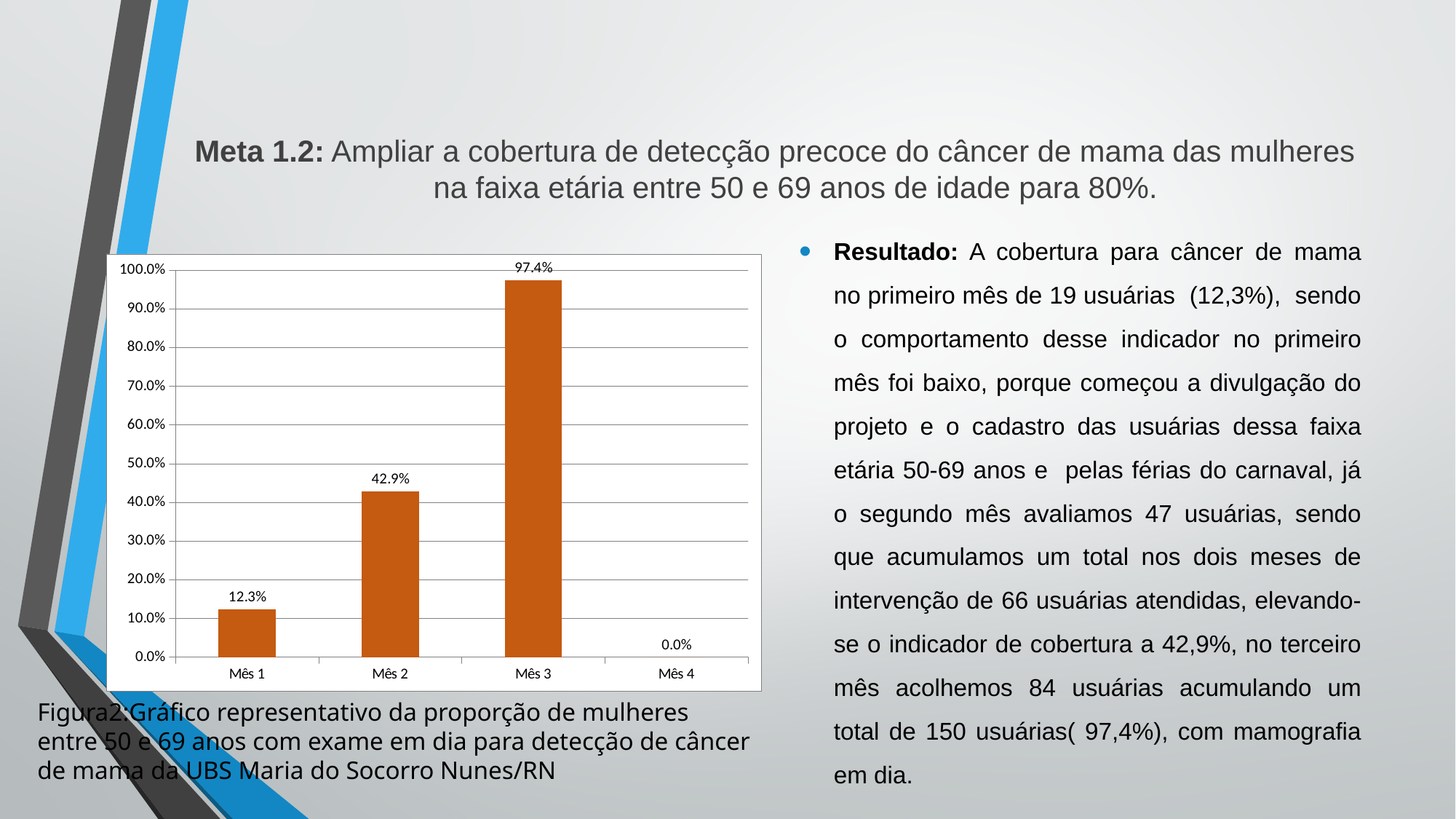
Which is larger, the value for Mês 1 or the value for Mês 2? Mês 2 What is the value for Mês 1? 12.3% Which month has the highest value? Mês 3 Which month has the lowest value? Mês 4 What is the value for Mês 2? 42.9% Is the value for Mês 3 greater or less than 90.0%? greater What is the value for Mês 4? 0.0% What is the difference between the values for Mês 3 and Mês 2? 54.5% What is the value for Mês 3? 97.4% What is the difference between the values for Mês 2 and Mês 1? 30.6% How many categories are shown on the x axis? 4 What kind of chart is shown on the slide? bar chart